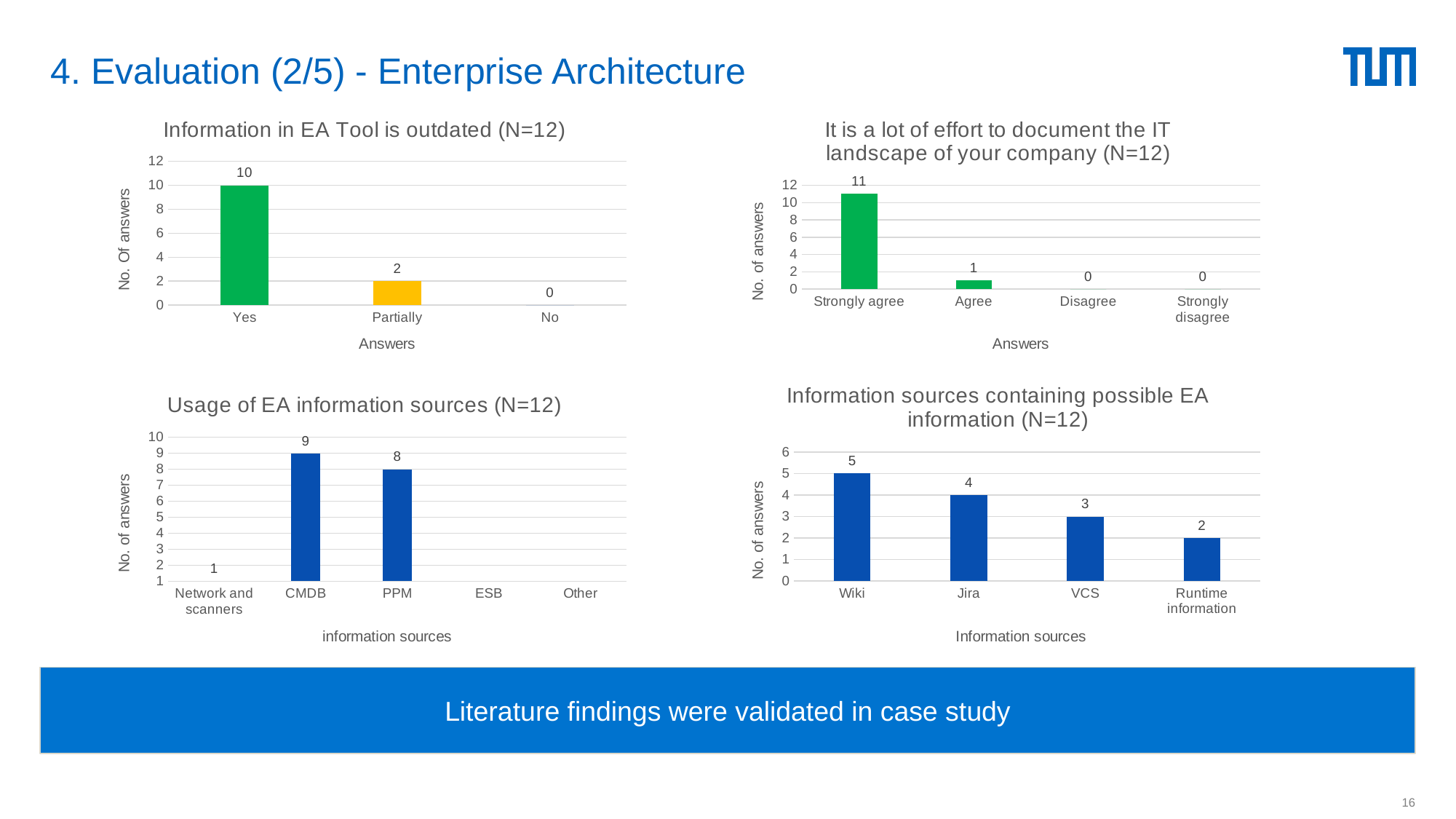
In the chart titled "Information in EA Tool is outdated (N=12)", how many answers were "Yes"? 10 In the chart titled "Information sources containing possible EA information (N=12)", how many answers were given for VCS? 3 In the chart titled "Usage of EA information sources (N=12)", how many answers were given for CMDB? 9 In the chart titled "Usage of EA information sources (N=12)", which has more answers, CMDB or PPM? CMDB In the chart titled "It is a lot of effort to document the IT landscape of your company (N=12)", do the values rise or fall from left to right along the x axis? fall What kind of chart is the chart titled "Information sources containing possible EA information (N=12)"? bar chart In the chart titled "Information in EA Tool is outdated (N=12)", which answer has the lowest number of answers? No In the chart titled "Information sources containing possible EA information (N=12)", what is the difference between the values for Wiki and Runtime information? 3 In the chart titled "Usage of EA information sources (N=12)", which information source has the highest number of answers? CMDB In the chart titled "It is a lot of effort to document the IT landscape of your company (N=12)", how many answer categories are shown on the x axis? 4 In the chart titled "Information in EA Tool is outdated (N=12)", what is the difference between the number of "Yes" and "Partially" answers? 8 In the chart titled "It is a lot of effort to document the IT landscape of your company (N=12)", how many answers were "Strongly agree"? 11